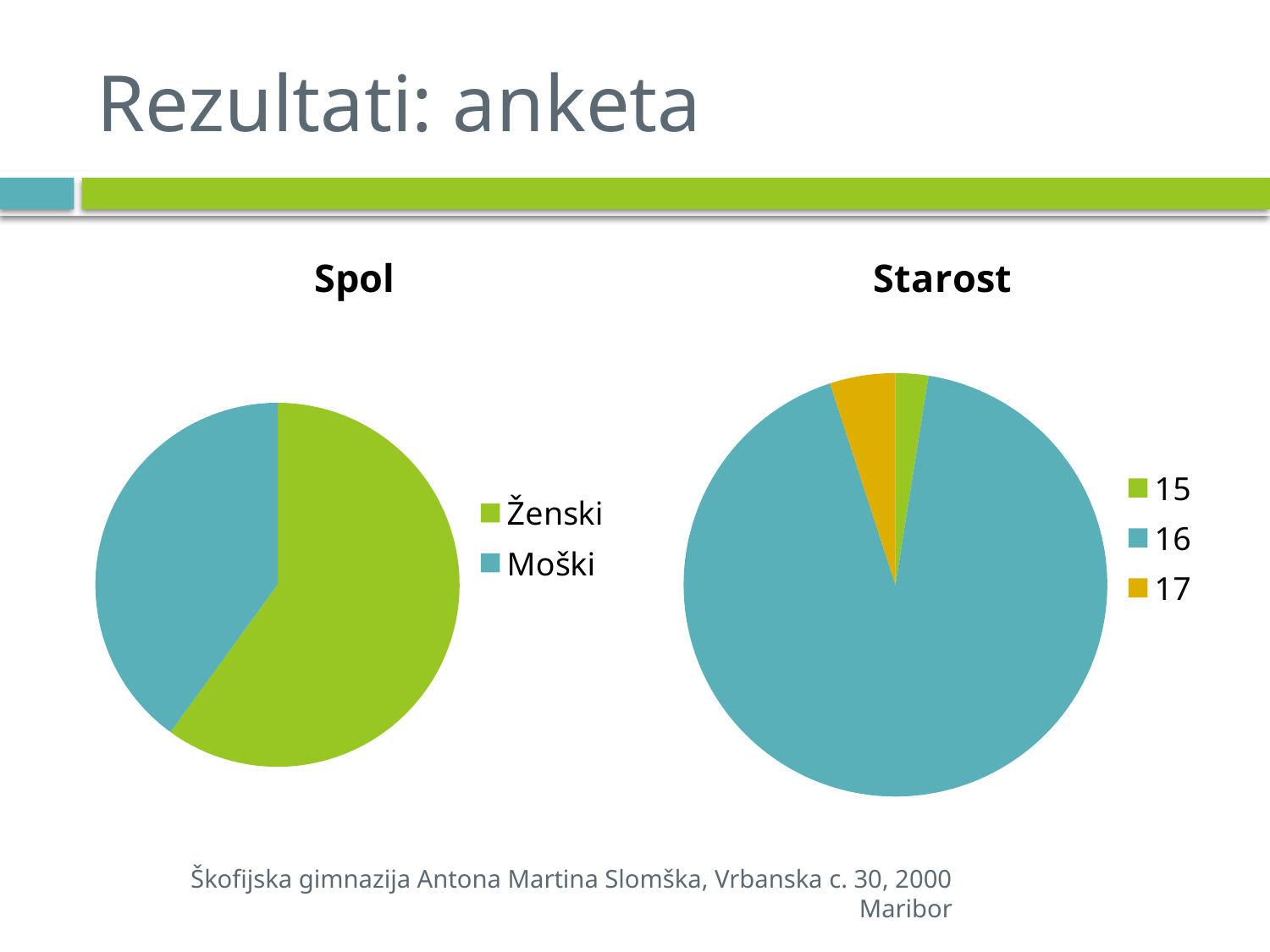
In the "Spol" chart, which slice is larger, Ženski or Moški? Ženski What kind of chart is the "Starost" chart? pie chart How many categories does the legend of the "Spol" chart list? 2 In the "Spol" chart, what colour is the Moški slice? blue In the "Spol" chart, which category has the smallest slice? Moški What kind of chart is the "Spol" chart? pie chart How many categories does the legend of the "Starost" chart list? 3 In the "Starost" chart, which slice is larger, 16 or 17? 16 What are the legend entries of the "Starost" chart? 15, 16, 17 In the "Spol" chart, which category has the largest slice? Ženski In the "Starost" chart, which category has the largest slice? 16